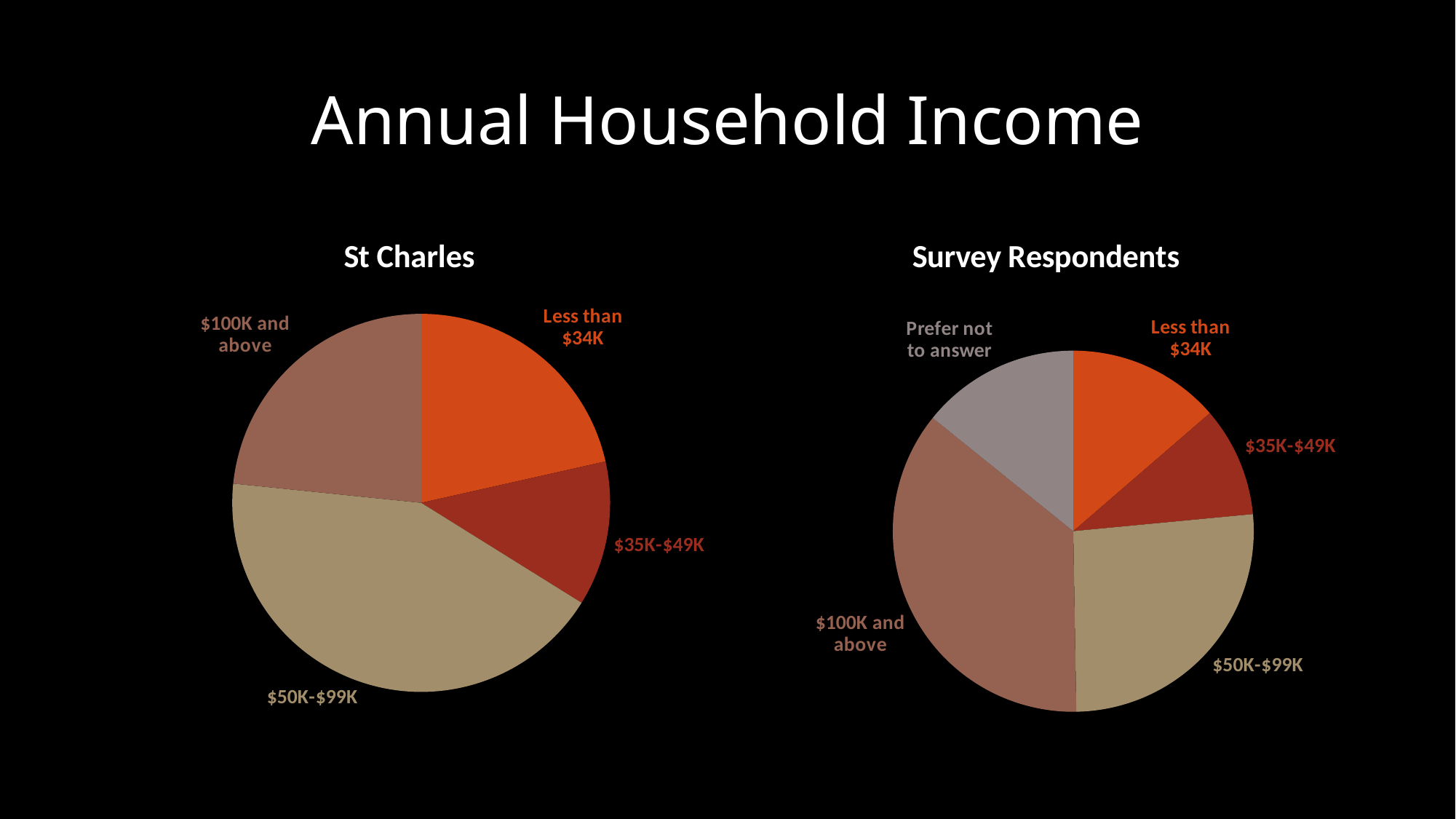
In the St Charles chart, which slice is larger: $35K-$49K or $50K-$99K? $50K-$99K What kind of chart is the St Charles chart? Pie chart How many slices does the St Charles pie chart have? 4 In the Survey Respondents chart, which slice is larger: $50K-$99K or Less than $34K? $50K-$99K Which category appears in the Survey Respondents chart but not in the St Charles chart? Prefer not to answer How many slices does the Survey Respondents pie chart have? 5 In the St Charles chart, which income category has the smallest slice? $35K-$49K What is the title of the slide containing the two pie charts? Annual Household Income In the St Charles chart, which slice is larger: Less than $34K or $100K and above? $100K and above In the Survey Respondents chart, which category has the smallest slice? $35K-$49K In the St Charles chart, which income category has the largest slice? $50K-$99K